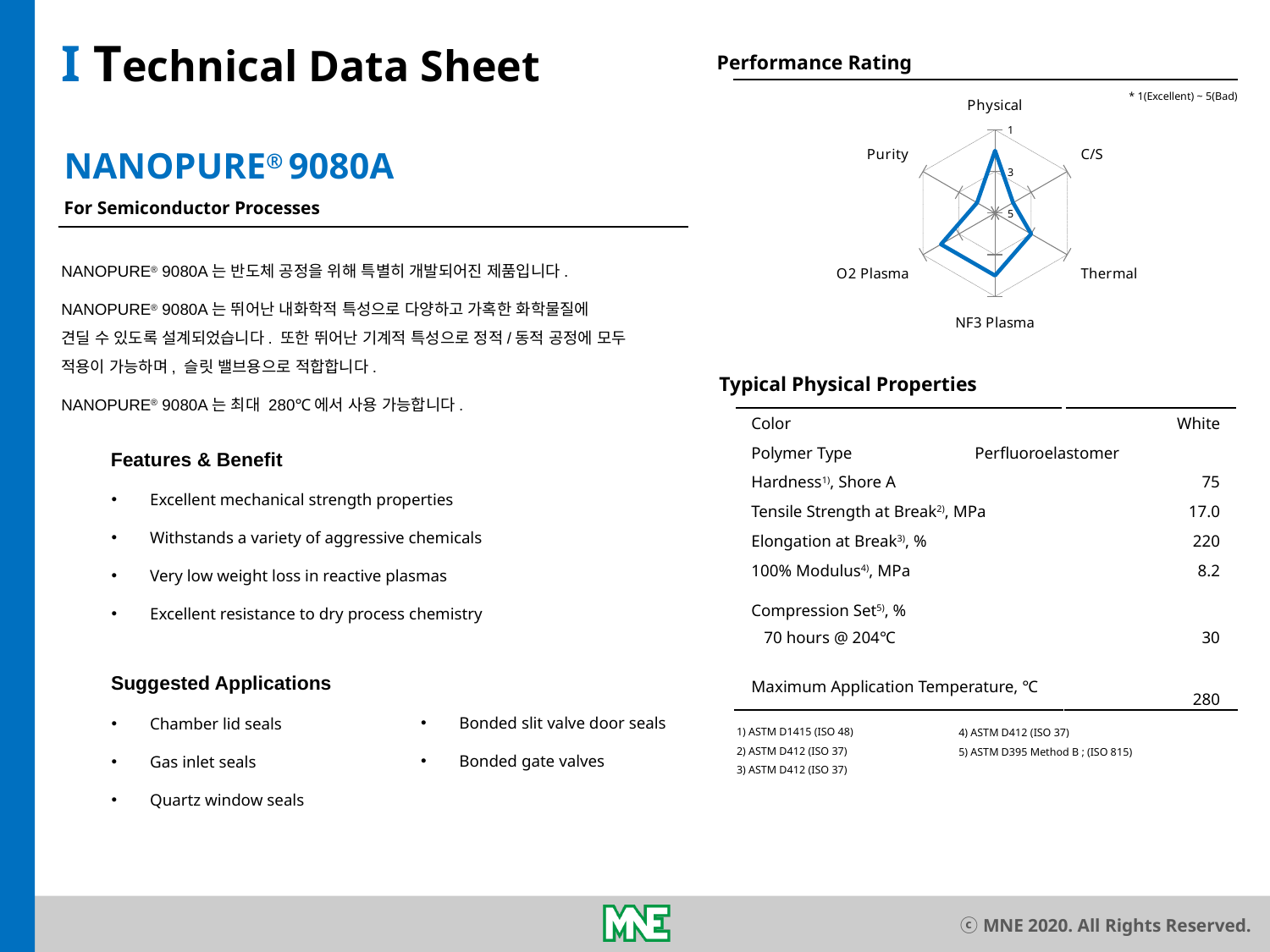
On the Performance Rating chart, is the rating for Physical greater or less than 3? less According to the note on the Performance Rating chart, what rating scale is used? 1(Excellent) ~ 5(Bad) What is the title of the radar chart on the slide? Performance Rating How many categories (axes) does the Performance Rating radar chart have? 6 On the Performance Rating chart, which has the better (lower) rating, Physical or C/S? Physical On the Performance Rating chart, is the rating for Purity greater or less than 3? greater On the Performance Rating chart, which has the better (lower) rating, O2 Plasma or Purity? O2 Plasma On the Performance Rating chart, is the rating for C/S greater or less than 3? greater What kind of chart is the Performance Rating chart? radar chart